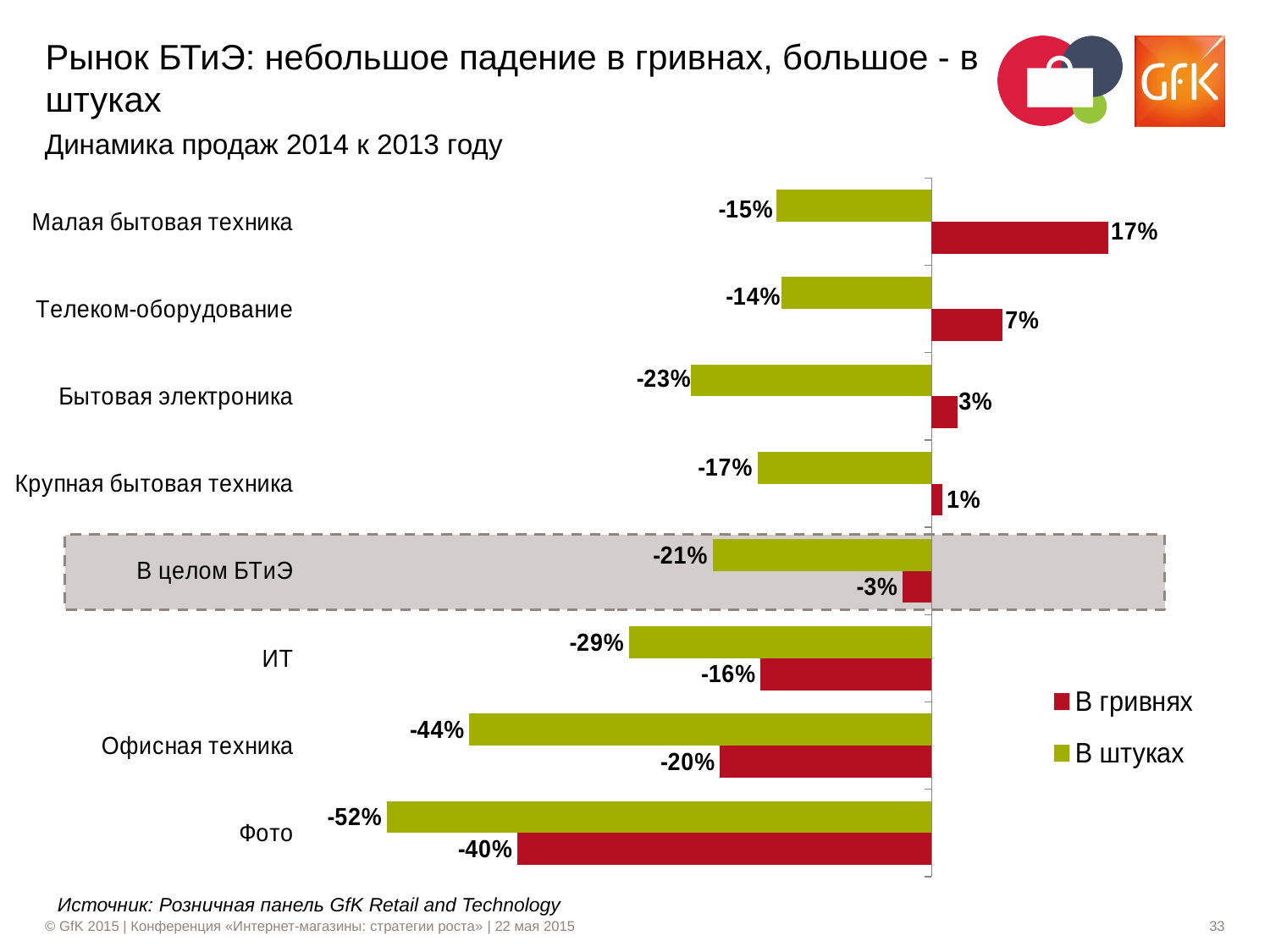
What is the difference between the В штуках and В гривнях values for Офисная техника? 24 percentage points Which is larger for Телеком-оборудование: the В гривнях value or the В штуках value? В гривнях What is the value for Малая бытовая техника in the В гривнях series? 17% Which category has the lowest value in the В штуках series? Фото What is the value for Бытовая электроника in the В штуках series? -23% Which colour represents the В штуках series? Green How many categories are shown on the chart? 8 What is the value for В целом БТиЭ in the В гривнях series? -3% What is the value for Фото in the В штуках series? -52% Which category has the highest value in the В гривнях series? Малая бытовая техника What kind of chart is shown on the slide? Bar chart How many series does the legend list? 2